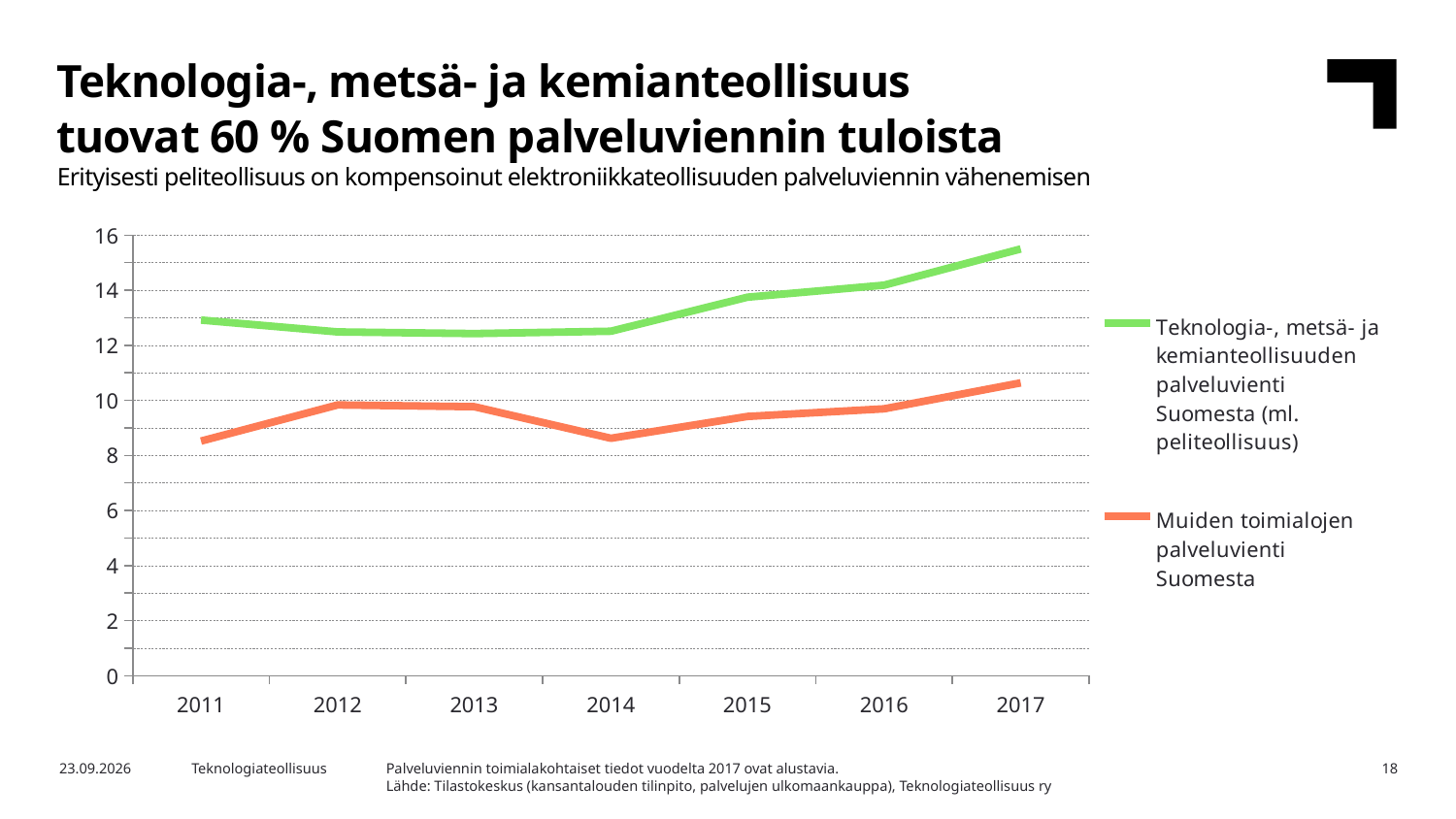
Is the value for 'Teknologia-, metsä- ja kemianteollisuuden palveluvienti Suomesta (ml. peliteollisuus)' in 2017 greater or less than 14? greater In 2015, which series has the larger value: 'Teknologia-, metsä- ja kemianteollisuuden palveluvienti Suomesta (ml. peliteollisuus)' or 'Muiden toimialojen palveluvienti Suomesta'? Teknologia-, metsä- ja kemianteollisuuden palveluvienti Suomesta (ml. peliteollisuus) Is the value for 'Muiden toimialojen palveluvienti Suomesta' in 2011 greater or less than 10? less Which year has the highest value for the series 'Teknologia-, metsä- ja kemianteollisuuden palveluvienti Suomesta (ml. peliteollisuus)'? 2017 Is the value for 'Teknologia-, metsä- ja kemianteollisuuden palveluvienti Suomesta (ml. peliteollisuus)' in 2013 greater or less than 12? greater Which colour is used for the series 'Muiden toimialojen palveluvienti Suomesta'? orange What kind of chart is shown on the slide? line chart Which year has the highest value for the series 'Muiden toimialojen palveluvienti Suomesta'? 2017 How many years are shown on the x axis? 7 Does the value for 'Teknologia-, metsä- ja kemianteollisuuden palveluvienti Suomesta (ml. peliteollisuus)' rise or fall from 2014 to 2017? rise How many series does the legend list? 2